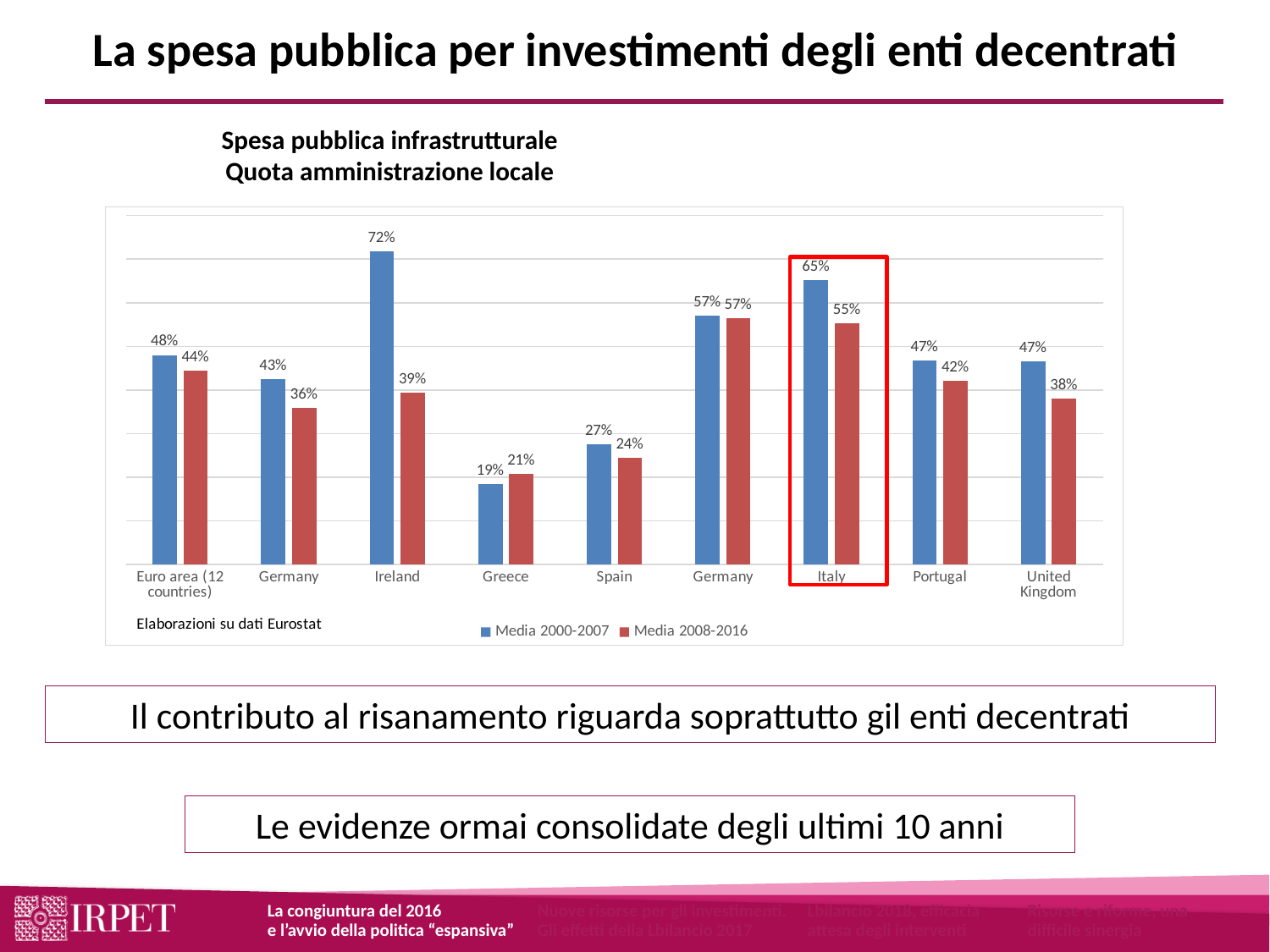
What is the difference between the Media 2000-2007 and Media 2008-2016 values for Italy? 10% What is the value for United Kingdom in the Media 2008-2016 series? 38% What is the difference between the Media 2000-2007 and Media 2008-2016 values for Ireland? 33% Which category is highlighted with a red box on the chart? Italy What is the value for Greece in the Media 2000-2007 series? 19% What is the value for Italy in the Media 2000-2007 series? 65% Which is larger for Greece: the Media 2000-2007 value or the Media 2008-2016 value? Media 2008-2016 Which category has the lowest value in the Media 2008-2016 series? Greece How many series does the legend list? 2 Which category has the highest value in the Media 2000-2007 series? Ireland What kind of chart is shown on the slide? Bar chart What is the value for Ireland in the Media 2008-2016 series? 39%